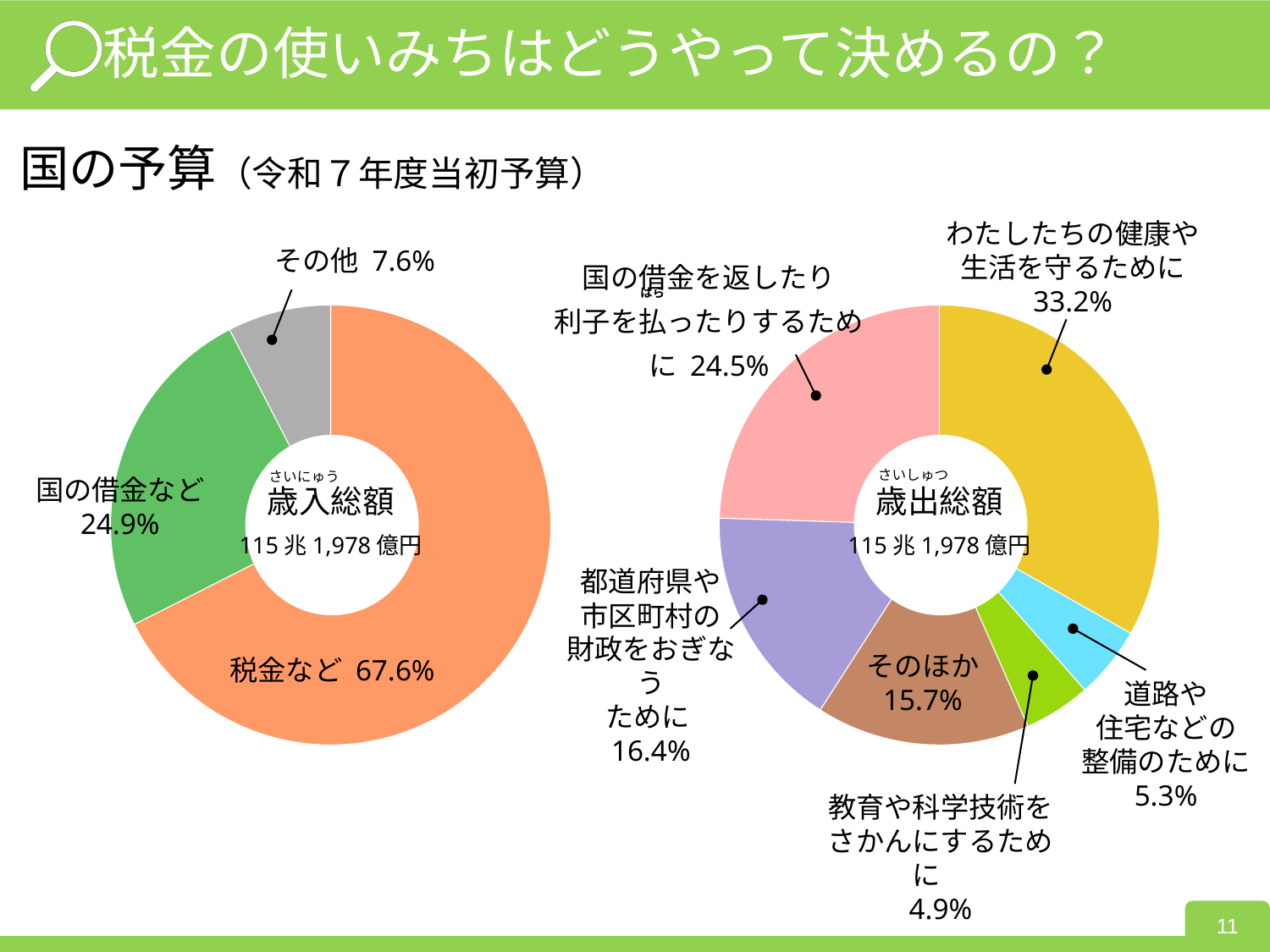
右の「歳出総額」のグラフで、最も割合が大きい項目はどれですか？ わたしたちの健康や生活を守るために 左の「歳入総額」のグラフで、最も割合が小さい項目はどれですか？ その他 右の「歳出総額」のグラフには、いくつの項目がありますか？ 6 左の「歳入総額」のグラフで、「税金など」の割合はいくらですか？ 67.6% 左の「歳入総額」のグラフで、「国の借金など」の割合はいくらですか？ 24.9% 左の「歳入総額」のグラフで、「税金など」と「国の借金など」の割合の差は何ポイントですか？ 42.7ポイント 右の「歳出総額」のグラフで、最も割合が小さい項目はどれですか？ 教育や科学技術をさかんにするために 右の「歳出総額」のグラフで、「道路や住宅などの整備のために」の割合はいくらですか？ 5.3% 右の「歳出総額」のグラフで、「わたしたちの健康や生活を守るために」の割合はいくらですか？ 33.2% 右の「歳出総額」のグラフで、「都道府県や市区町村の財政をおぎなうために」と「そのほか」では、どちらの割合が大きいですか？ 都道府県や市区町村の財政をおぎなうために 左の「歳入総額」のグラフには、いくつの項目がありますか？ 3 左の「歳入総額」のグラフの中央に書かれている総額はいくらですか？ 115兆1,978億円